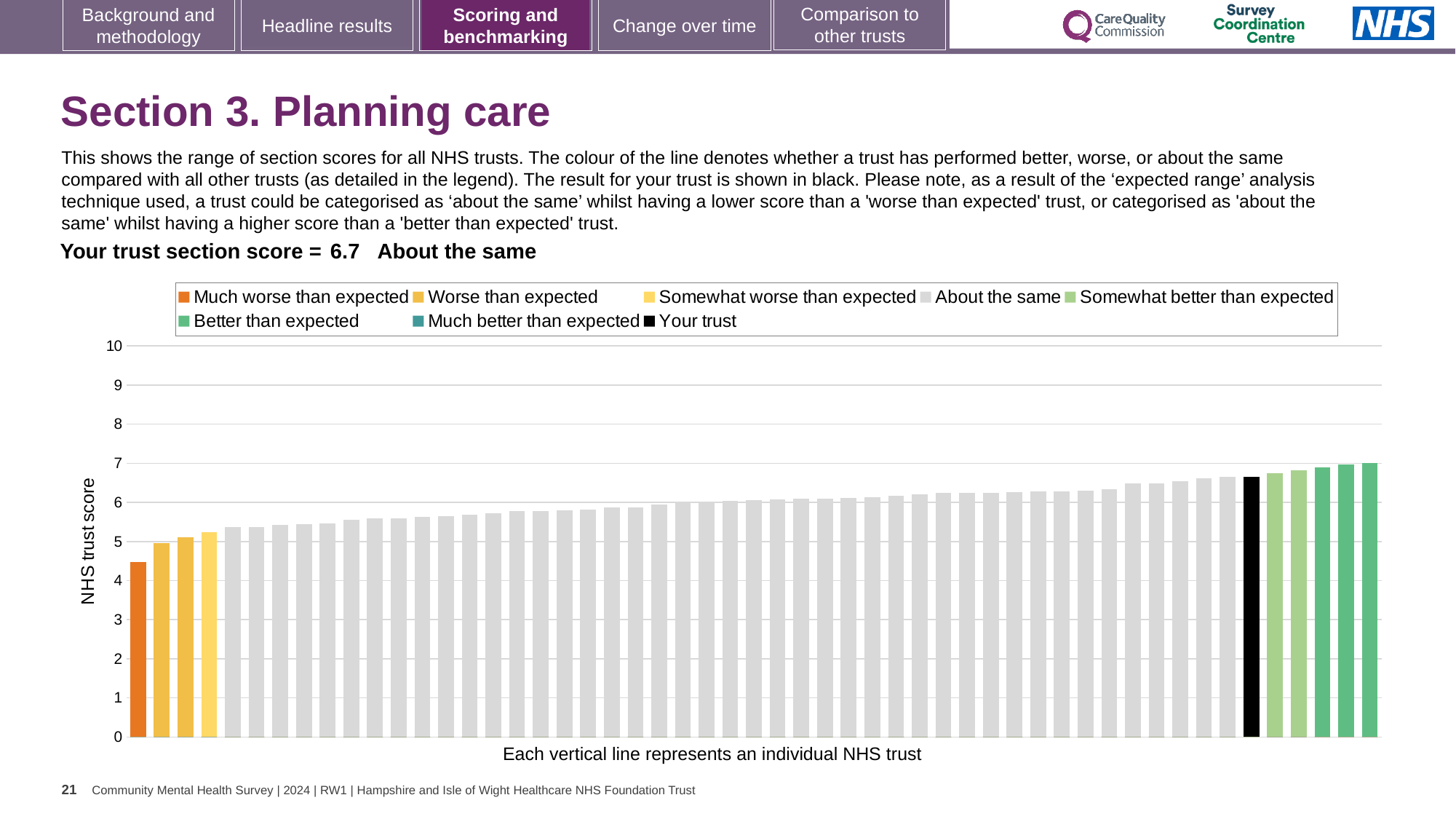
What is the label on the vertical axis of the chart? NHS trust score What type of chart is shown on the slide? bar chart How many trusts are shown in the 'Much worse than expected' colour? 1 Is the value of the lowest-scoring trust (the orange bar) greater or less than 5? less Which legend category does the lowest-scoring trust belong to? Much worse than expected Do the trust scores rise or fall from left to right along the x axis? rise How many entries does the chart legend list? 8 Is the value for your trust greater or less than 6? greater What colour is the bar representing your trust? black Is the value of the highest-scoring trust (the rightmost bar) greater or less than 6? greater What is the section score for your trust shown on the slide? 6.7 How is your trust's section score categorised compared with other trusts? About the same